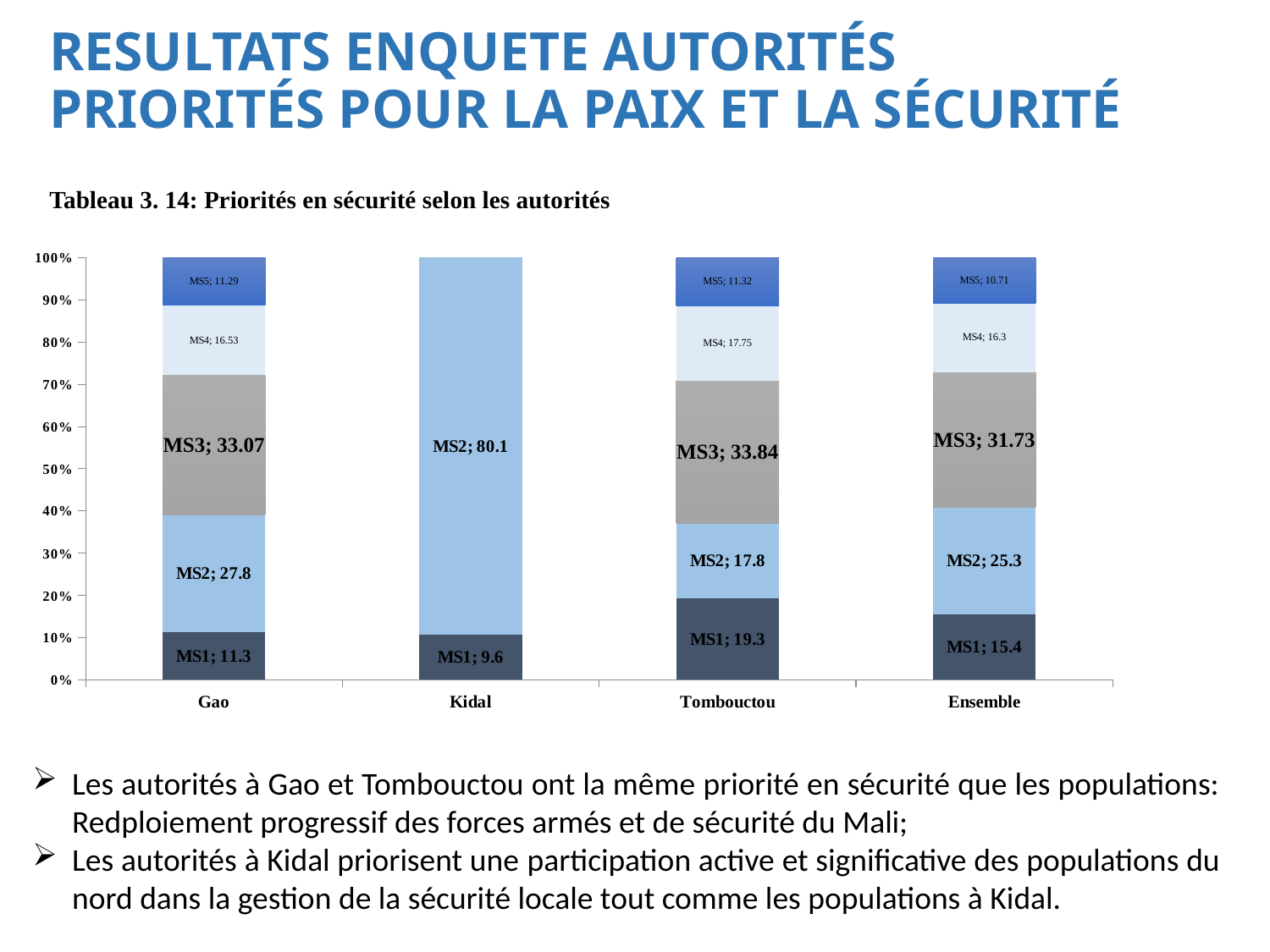
What is the value of MS5 for Ensemble? 10.71 What is the value of MS1 for Gao? 11.3 Which category has the lowest MS1 value? Kidal What is the value of MS3 for Tombouctou? 33.84 Which is larger, the MS3 value for Gao or the MS3 value for Ensemble? Gao What is the value of MS4 for Gao? 16.53 What is the value of MS2 for Kidal? 80.1 How many categories are shown on the x axis? 4 What is the difference between the MS2 values for Gao and Tombouctou? 10 What kind of chart is shown on the slide? Stacked bar chart What is the title of the chart? Tableau 3. 14: Priorités en sécurité selon les autorités Which category has the highest MS1 value? Tombouctou